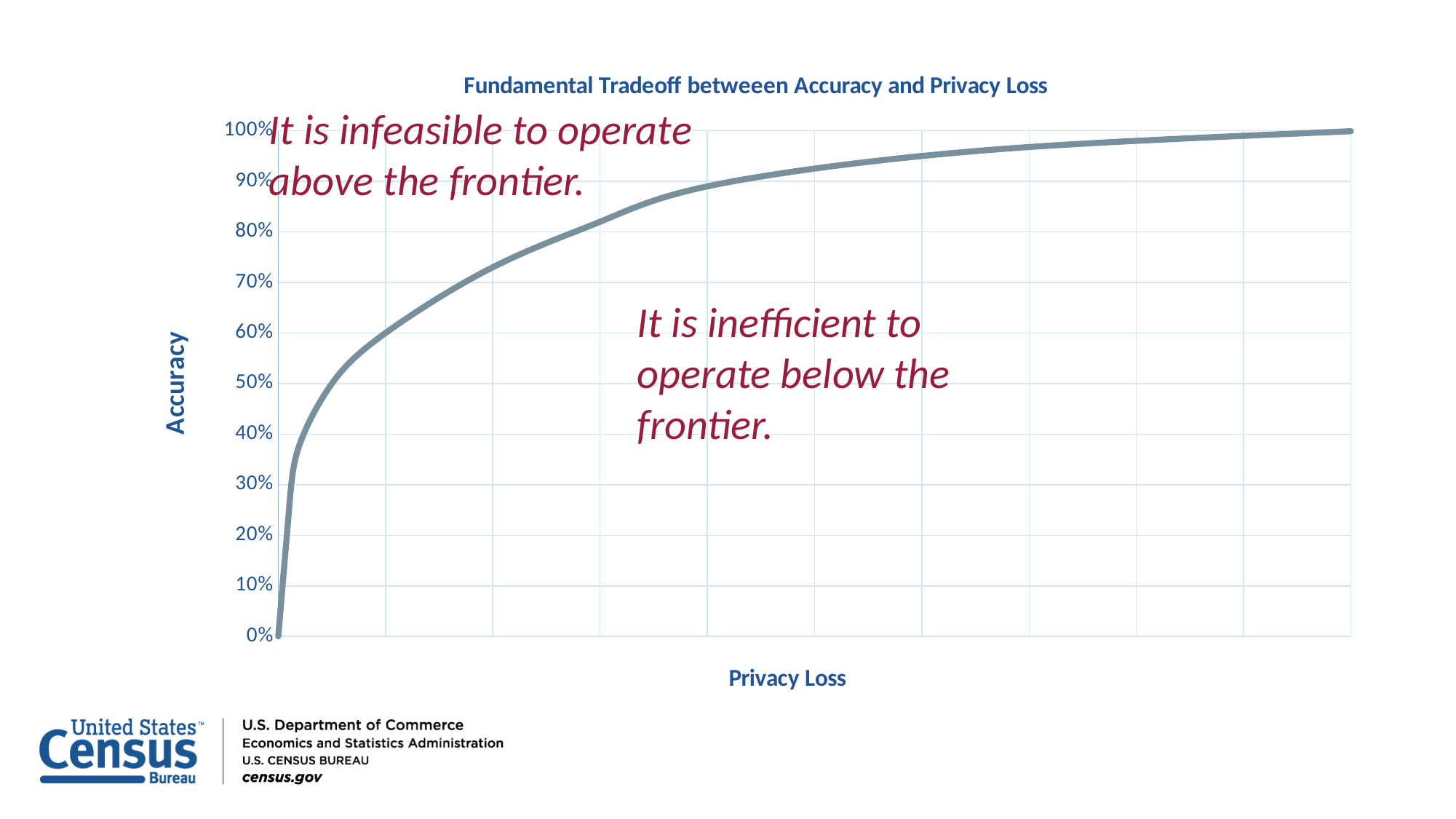
Is the accuracy at the far right end of the curve greater or less than 90%? greater At what accuracy value does the curve start at the left end of the x axis? 0% What is the label on the vertical axis of the chart? Accuracy Does accuracy rise or fall as privacy loss increases along the x axis? rises What kind of chart is shown on the slide? line chart Is the accuracy at the midpoint of the Privacy Loss axis greater or less than 80%? greater How many lines are plotted on the chart? 1 What is the title of the chart? Fundamental Tradeoff betweeen Accuracy and Privacy Loss